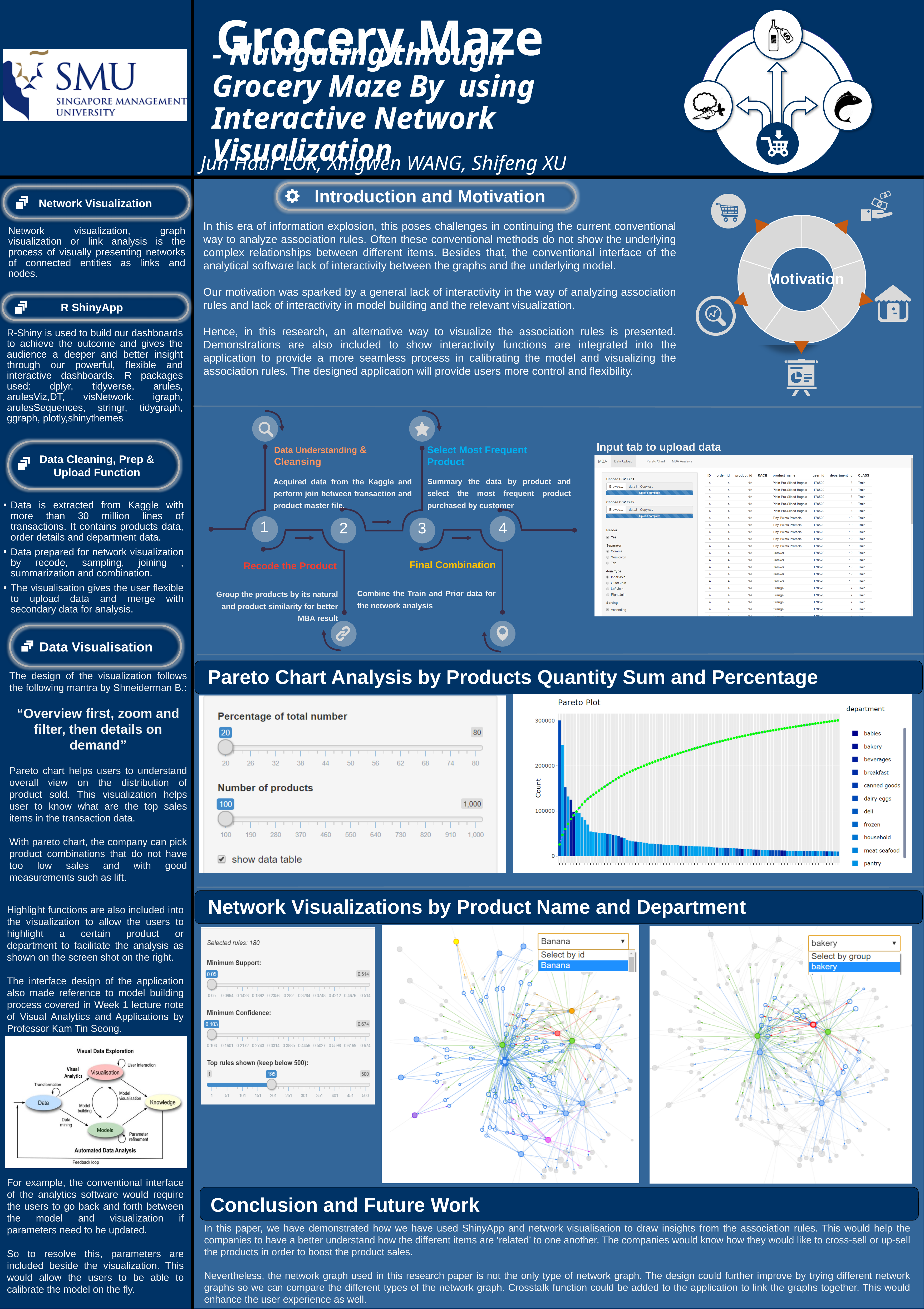
In the Pareto Plot, is the value of the second bar from the left greater or less than 300000? less In the Pareto Plot, is the value of the rightmost bar greater or less than 100000? less In the Pareto Plot, does the green dotted cumulative line rise or fall from left to right? rise In the Pareto Plot, which bar is the highest: the leftmost bar or the rightmost bar? the leftmost bar In the Pareto Plot, what is the title of the legend? department In the Pareto Plot, is the value of the tallest bar greater or less than 200000? greater What kind of chart is the Pareto Plot? bar chart In the Pareto Plot, do the bar heights rise or fall from left to right along the x axis? fall What is the title of the chart in the Pareto Chart Analysis section? Pareto Plot